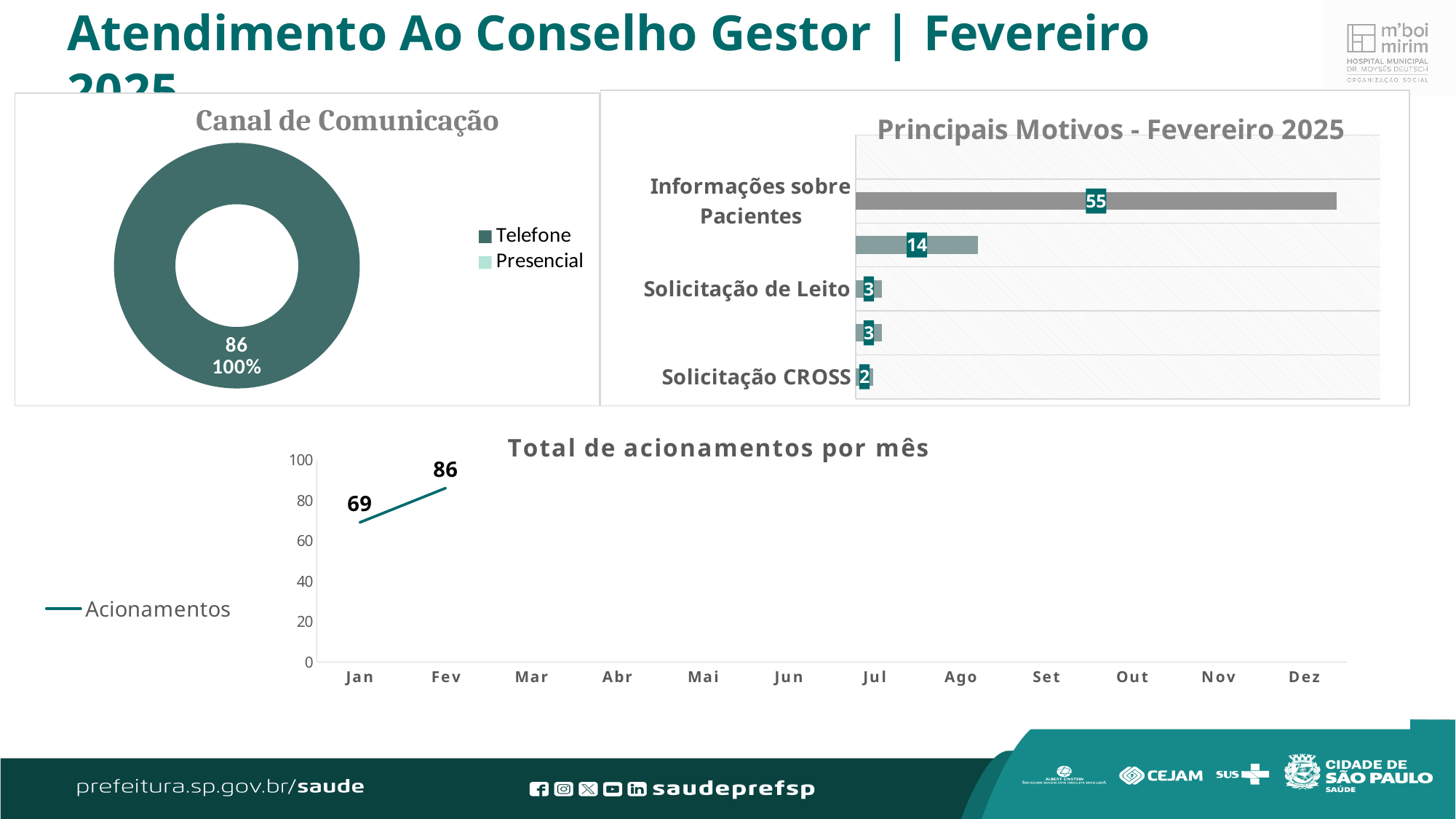
In the 'Principais Motivos - Fevereiro 2025' chart, which category has the highest value? Informações sobre Pacientes In the 'Canal de Comunicação' chart, what share of the total does Telefone represent? 100% What kind of chart is 'Canal de Comunicação'? Donut (pie) chart In the 'Total de acionamentos por mês' chart, what is the value for Jan? 69 What kind of chart is 'Principais Motivos - Fevereiro 2025'? Bar chart How many entries does the legend of the 'Canal de Comunicação' chart list? 2 In the 'Principais Motivos - Fevereiro 2025' chart, what is the value for 'Informações sobre Pacientes'? 55 In the 'Principais Motivos - Fevereiro 2025' chart, what is the value for 'Solicitação CROSS'? 2 In the 'Total de acionamentos por mês' chart, do the values rise or fall from Jan to Fev? Rise In the 'Total de acionamentos por mês' chart, what is the difference between Fev and Jan? 17 In the 'Principais Motivos - Fevereiro 2025' chart, what is the difference between 'Informações sobre Pacientes' and 'Solicitação de Leito'? 52 In the 'Canal de Comunicação' chart, what value is shown for Telefone? 86